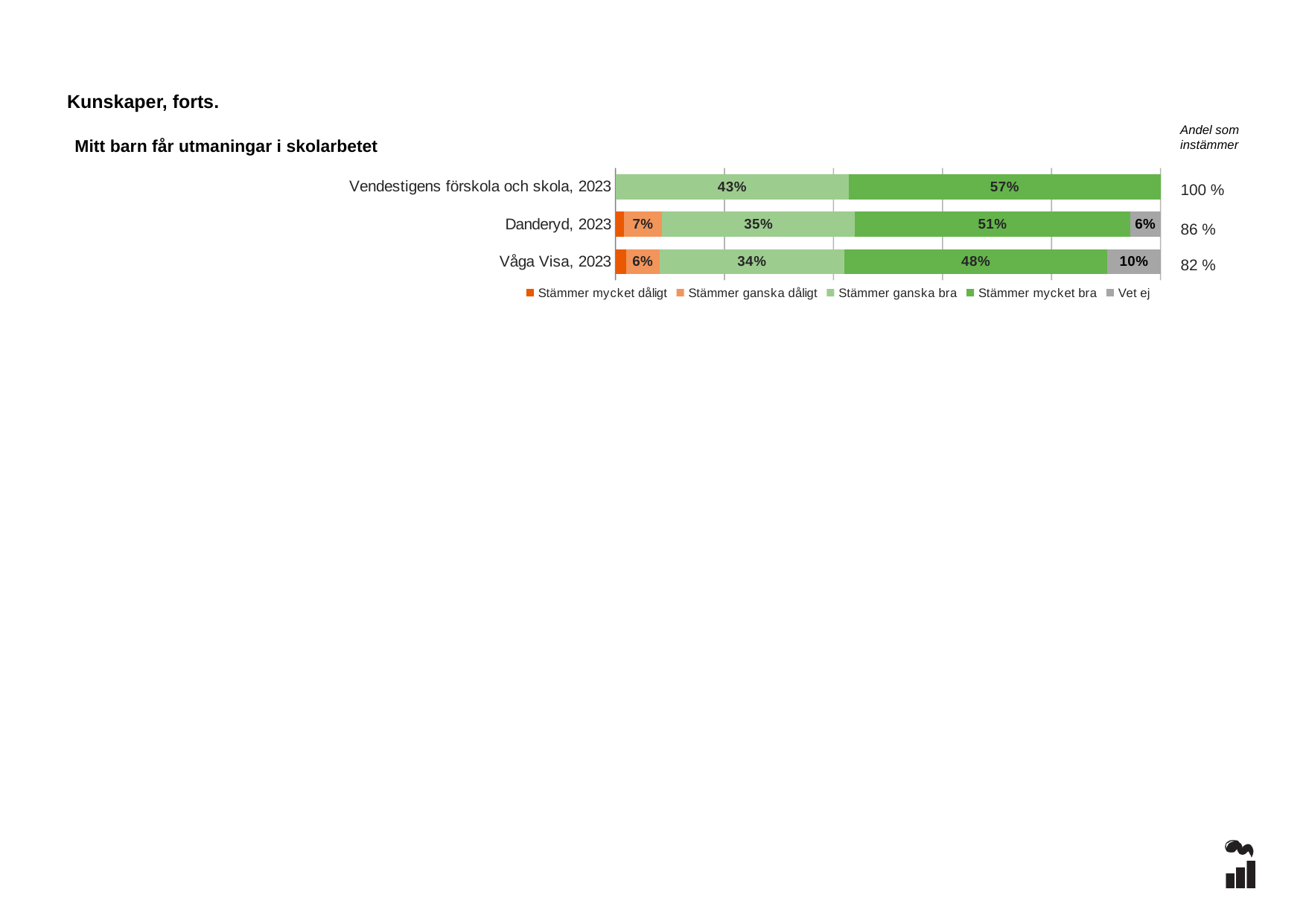
What is the value of "Vet ej" for Våga Visa, 2023? 10% What is the value of "Stämmer ganska dåligt" for Danderyd, 2023? 7% What is the "Andel som instämmer" value shown for Danderyd, 2023? 86 % What is the difference between the "Stämmer mycket bra" values for Danderyd, 2023 and Våga Visa, 2023? 3 percentage points Which category has the highest value for "Stämmer mycket bra"? Vendestigens förskola och skola, 2023 How many series does the legend list? 5 What is the value of "Stämmer mycket bra" for Vendestigens förskola och skola, 2023? 57% What type of chart is shown on the slide? Stacked bar chart How many categories (bars) does the chart show? 3 What is the value of "Stämmer ganska bra" for Danderyd, 2023? 35% Which is larger: "Vet ej" for Danderyd, 2023 or "Vet ej" for Våga Visa, 2023? Våga Visa, 2023 Which category has the lowest value for "Stämmer ganska bra"? Våga Visa, 2023